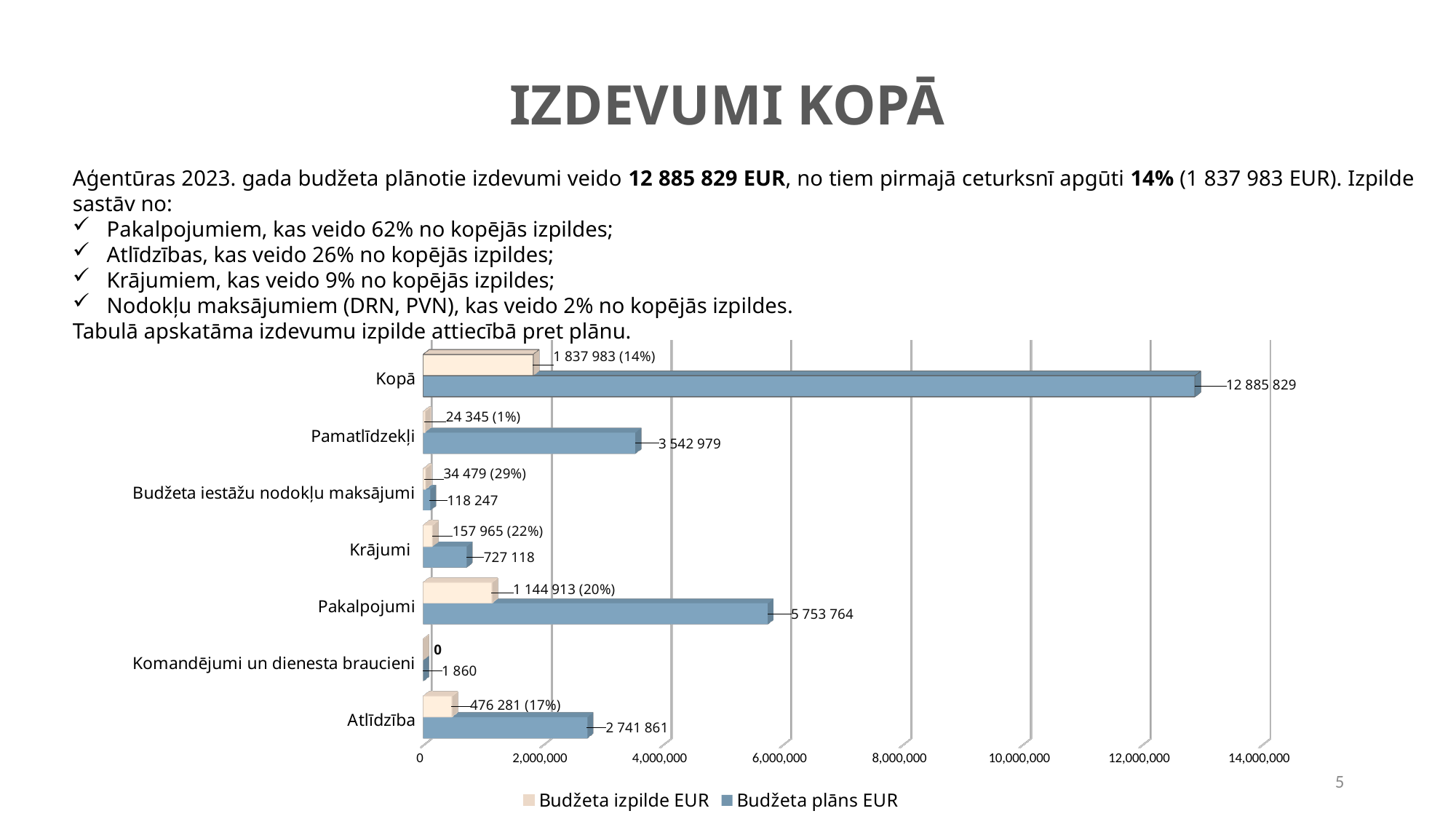
How many categories are shown on the chart? 7 Which is larger: the Budžeta plāns EUR value for Pamatlīdzekļi or for Atlīdzība? Pamatlīdzekļi What is the Budžeta plāns EUR value for Krājumi? 727 118 What is the Budžeta izpilde EUR value for Komandējumi un dienesta braucieni? 0 Which category has the lowest Budžeta plāns EUR value? Komandējumi un dienesta braucieni What is the Budžeta izpilde EUR value for Atlīdzība? 476 281 (17%) What is the difference between the Budžeta plāns EUR and Budžeta izpilde EUR values for Pakalpojumi? 4 608 851 What is the Budžeta plāns EUR value for Pakalpojumi? 5 753 764 Which category has the highest Budžeta plāns EUR value? Kopā How many series does the legend list? 2 Is the Budžeta plāns EUR value for Kopā greater or less than 12,000,000? greater What kind of chart is shown on the slide? bar chart